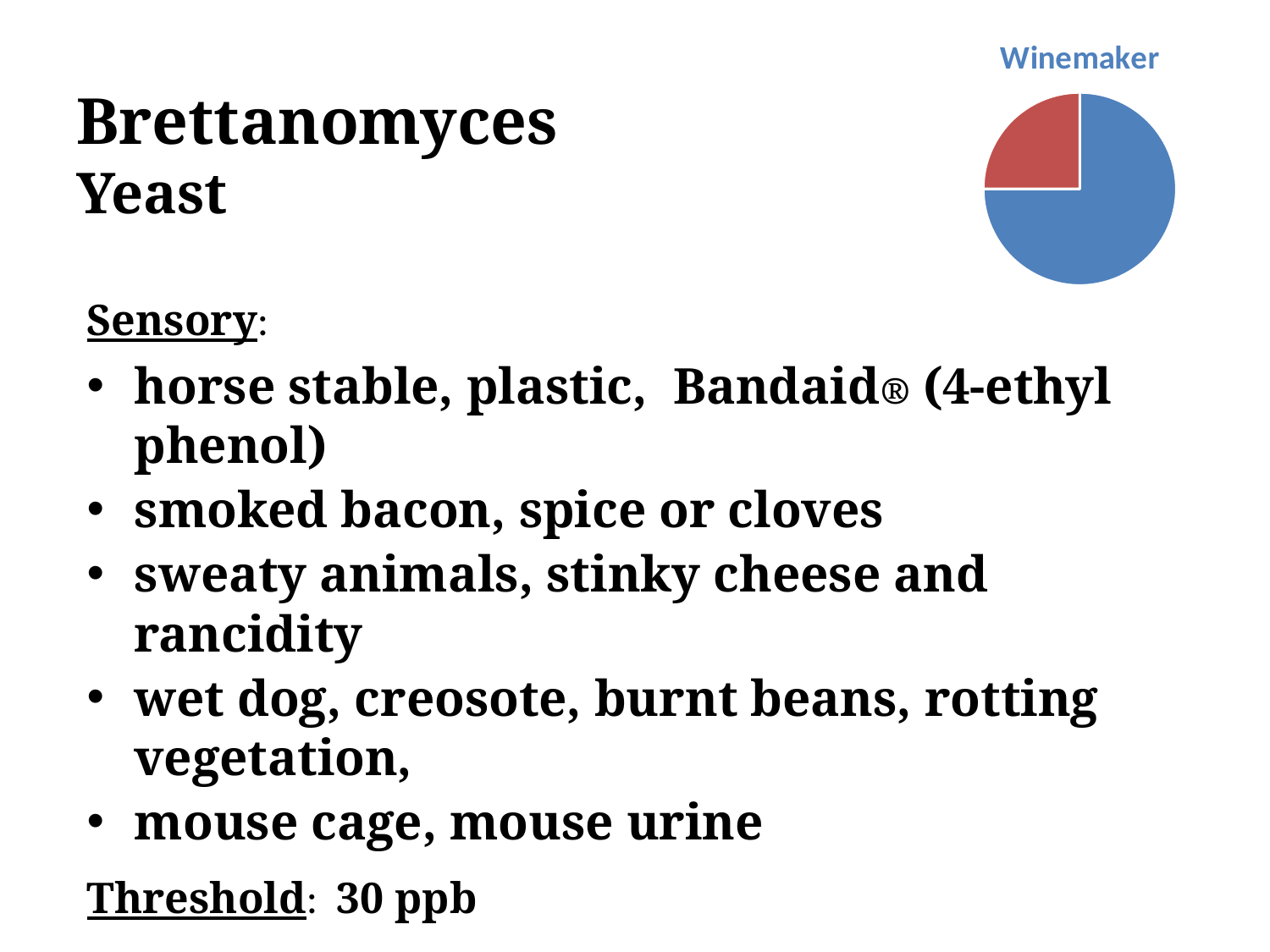
What kind of chart is shown in the top right of the slide? pie chart In the Winemaker pie chart, which colour slice is the smallest? red Does the Winemaker pie chart show a legend? No In the Winemaker pie chart, which colour slice is the largest? blue In the Winemaker pie chart, which slice is larger, the blue one or the red one? the blue one What is the title of the pie chart on the slide? Winemaker How many slices does the Winemaker pie chart have? 2